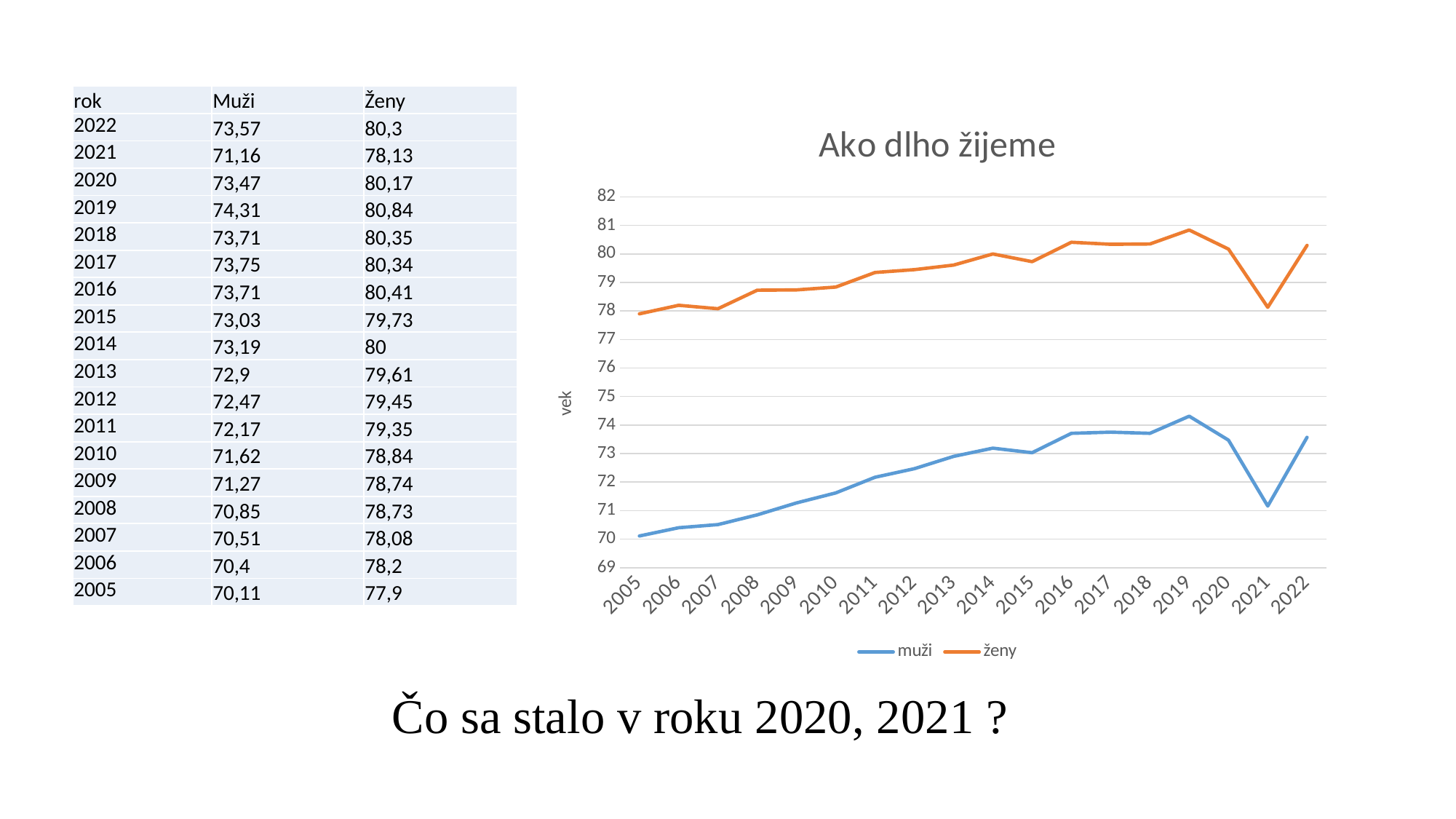
How many series does the chart legend list? 2 What is the difference between the ženy and muži values in 2022? 6,73 What is the value for ženy in 2022? 80,3 In which year is the value for muži highest? 2019 What is the title of the chart? Ako dlho žijeme How many years are plotted along the x axis? 18 Which year has the larger value for muži, 2020 or 2021? 2020 In which year is the value for ženy lowest? 2005 What is the value for muži in 2005? 70,11 What kind of chart is shown on the slide? line chart Does the muži line rise or fall from 2005 to 2019? rise Is the value for muži in 2021 greater or less than 72? less